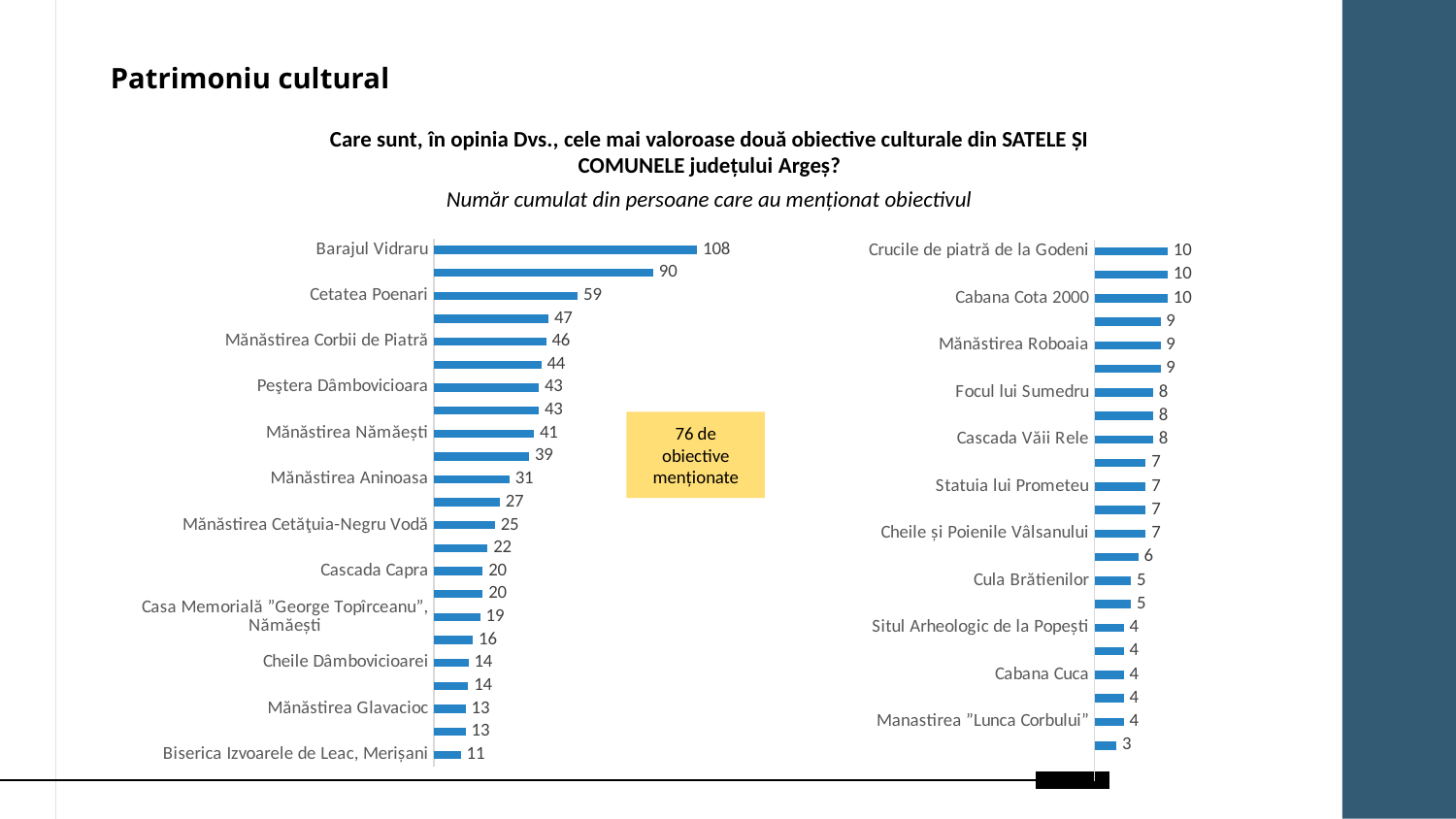
In the right chart, what is the value for Cula Brătienilor? 5 According to the yellow box on the slide, how many objectives were mentioned in total? 76 What type of chart is used on this slide? Bar chart In the right chart, what is the difference between the values for Crucile de piatră de la Godeni and Cabana Cuca? 6 In the left chart, what is the value for Cetatea Poenari? 59 In the left chart, which labeled category has the lowest value? Biserica Izvoarele de Leac, Merișani In the left chart, which category has the highest value? Barajul Vidraru In the right chart, what is the value for Cabana Cota 2000? 10 In the left chart, which is larger: the value for Peștera Dâmbovicioara or the value for Cascada Capra? Peștera Dâmbovicioara In the left chart, what is the value for Barajul Vidraru? 108 In the left chart, what is the value for Mănăstirea Aninoasa? 31 In the left chart, what is the difference between the values for Barajul Vidraru and Cetatea Poenari? 49